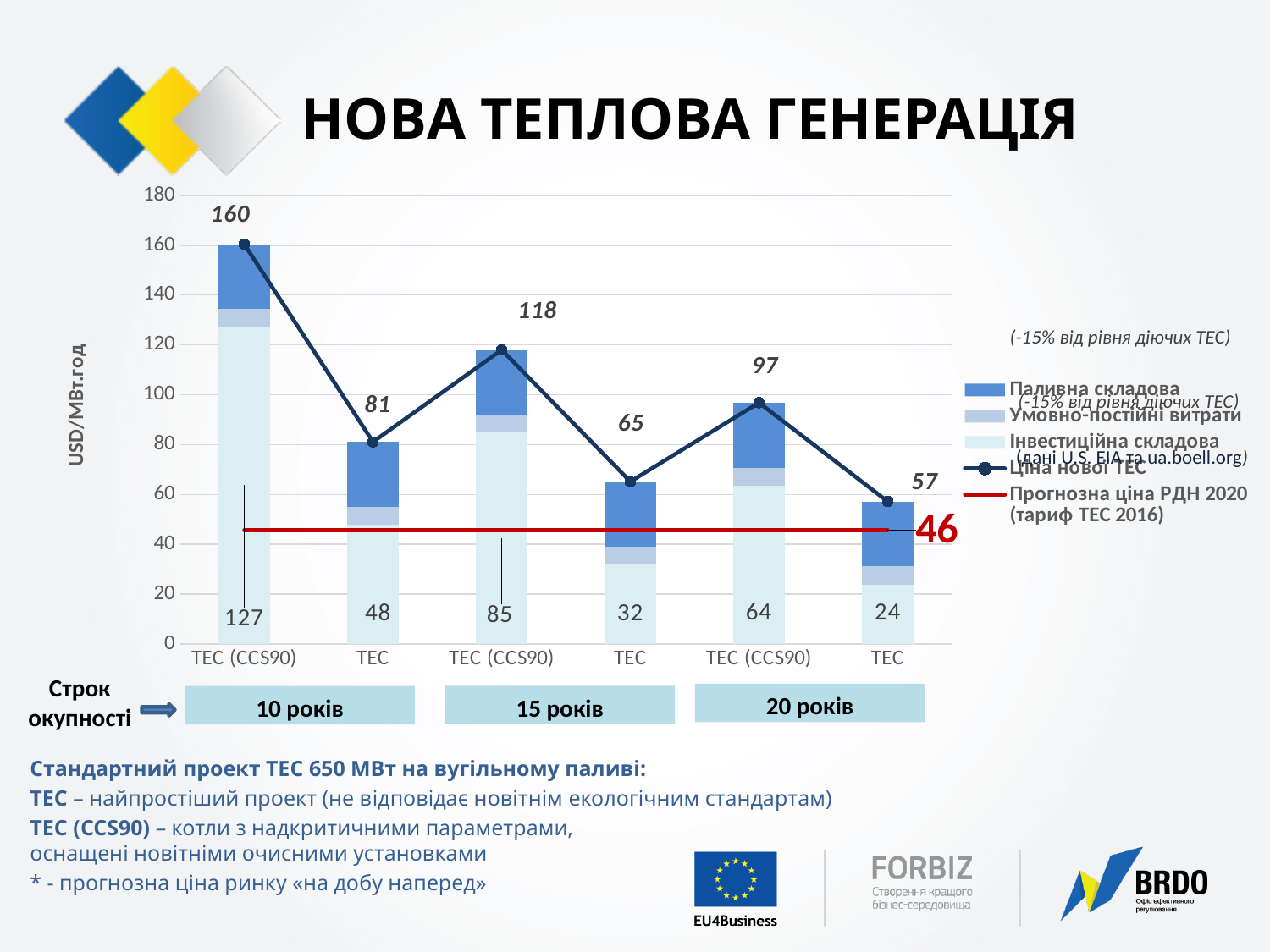
How many entries does the chart legend list? 5 What is the value of the 'Ціна нової ТЕС' line for ТЕС (CCS90) in the 10 років group? 160 What is the 'Інвестиційна складова' value for ТЕС (CCS90) in the 15 років group? 85 Which is larger: the 'Ціна нової ТЕС' value for ТЕС in the 10 років group or for ТЕС (CCS90) in the 20 років group? ТЕС (CCS90) in the 20 років group What unit is shown on the vertical axis of the chart? USD/МВт.год Which bar has the highest 'Ціна нової ТЕС' value? ТЕС (CCS90) in the 10 років group At what value is the red 'Прогнозна ціна РДН 2020 (тариф ТЕС 2016)' line drawn? 46 Which bar has the lowest 'Ціна нової ТЕС' value? ТЕС in the 20 років group What is the 'Інвестиційна складова' value for ТЕС in the 10 років group? 48 How many bars are plotted on the chart? 6 What is the difference between the 'Ціна нової ТЕС' values for ТЕС (CCS90) and ТЕС in the 15 років group? 53 What is the value of the 'Ціна нової ТЕС' line for ТЕС in the 20 років group? 57